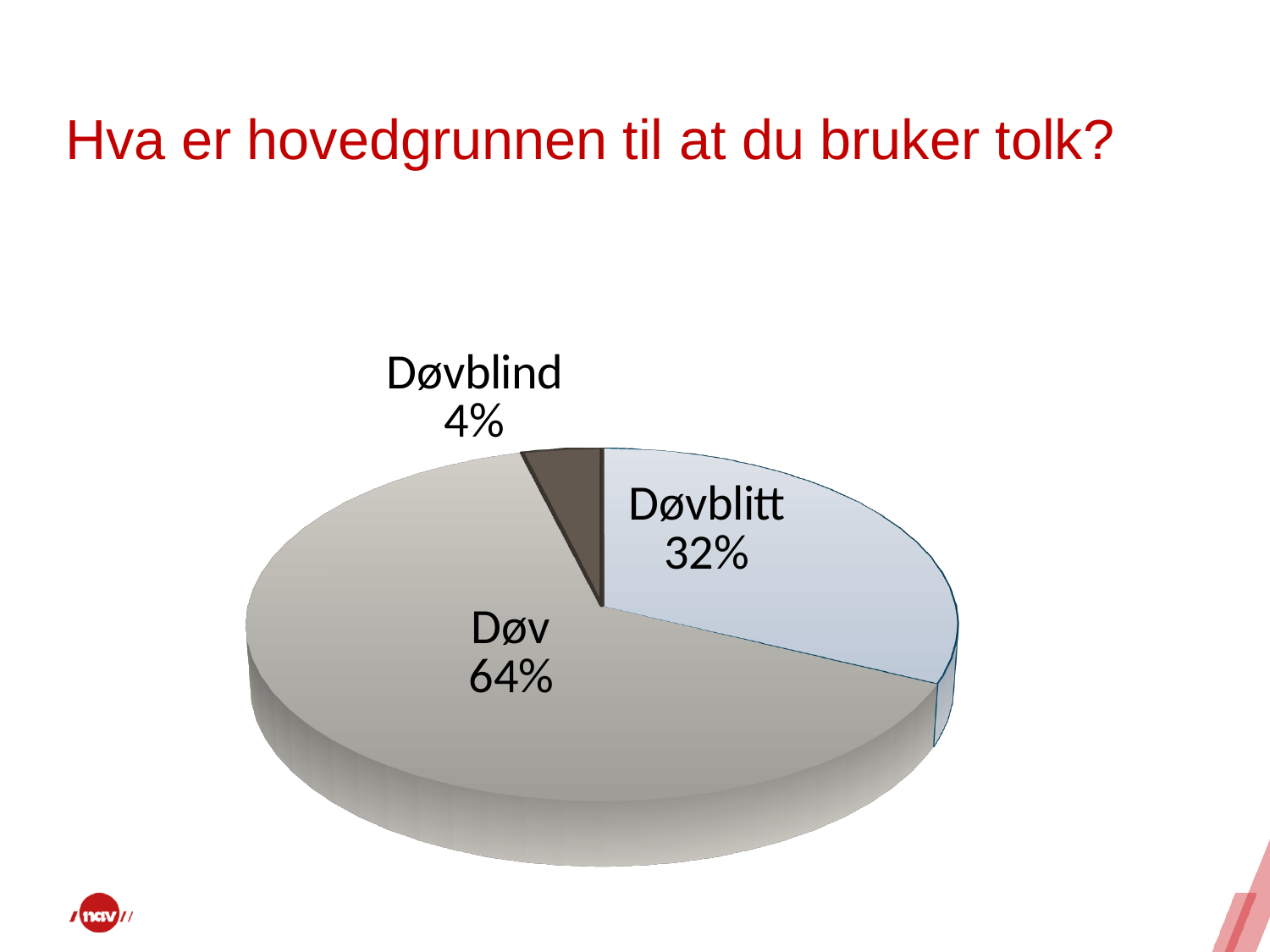
How many slices does the pie chart have? 3 What colour is the Døvblitt slice of the pie? light blue Which category has the smallest slice of the pie? Døvblind What is the difference in percentage points between Døvblitt and Døvblind? 28 What kind of chart is shown on the slide? pie chart What is the title of the slide containing the pie chart? Hva er hovedgrunnen til at du bruker tolk? Which category has the largest slice of the pie? Døv What is the difference in percentage points between Døv and Døvblitt? 32 What share of the pie does Døvblind represent? 4% What share of the pie does Døvblitt represent? 32% Which is larger, the share for Døvblitt or the share for Døvblind? Døvblitt What share of the pie does Døv represent? 64%